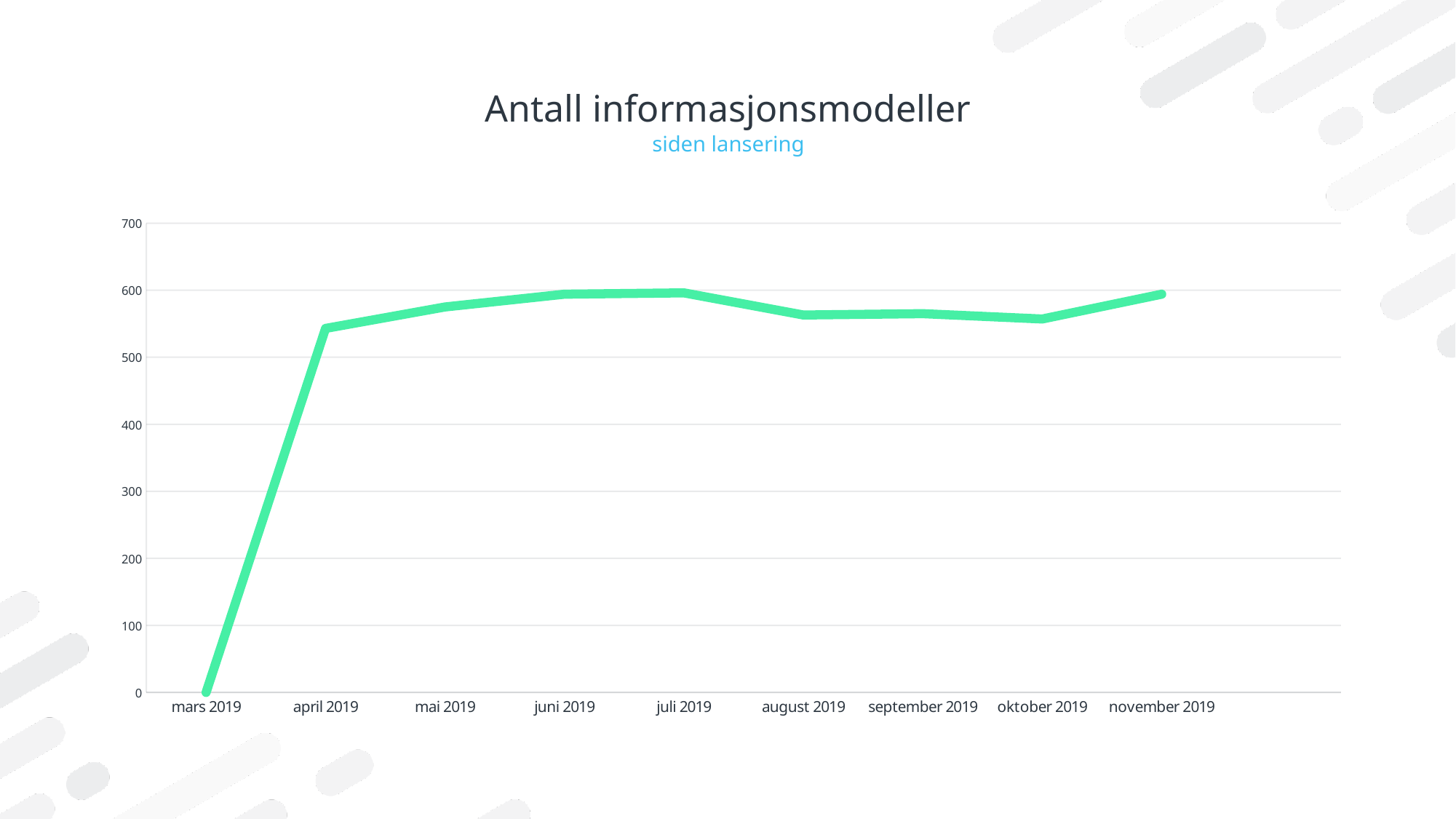
Do the values rise or fall from mars 2019 to juli 2019? rise What subtitle appears under the chart title? siden lansering Which is larger, the value for juli 2019 or the value for august 2019? juli 2019 What is the value for mars 2019? 0 Is the value for april 2019 greater or less than 500? greater Which month has the lowest value? mars 2019 Is the value for oktober 2019 greater or less than 500? greater What kind of chart is shown on the slide? line chart Is the value for august 2019 greater or less than 600? less How many months are plotted along the x axis? 9 What is the title of the chart? Antall informasjonsmodeller Which is larger, the value for mars 2019 or the value for april 2019? april 2019